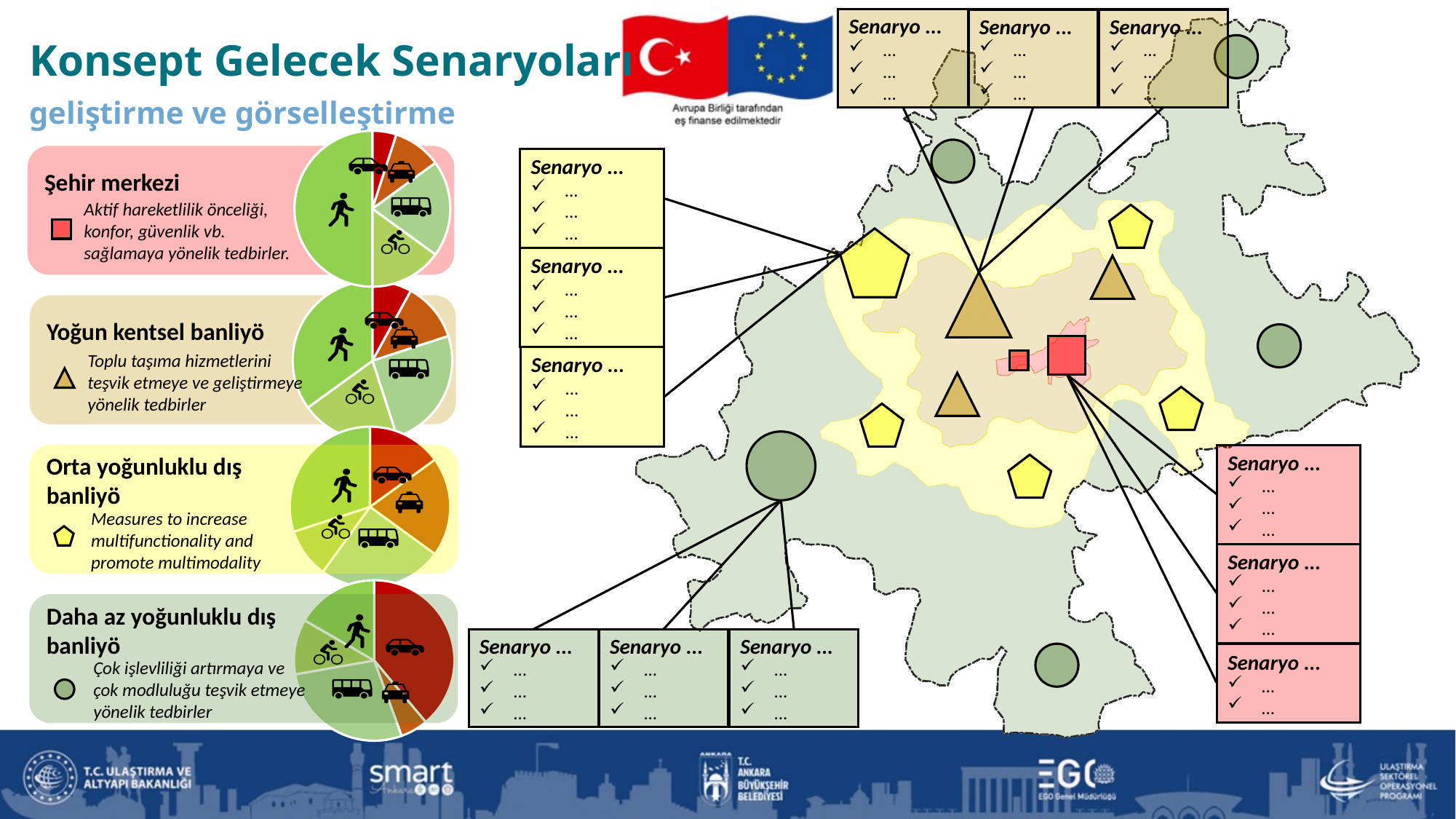
What colour is the walking slice in the pie chart next to "Şehir merkezi"? green What is the main title of the slide? Konsept Gelecek Senaryoları In the pie chart next to "Daha az yoğunluklu dış banliyö", is the car slice larger or smaller than the bicycle slice? larger How many pie charts are shown on the left side of the slide? 4 Which pie chart on the slide has the largest car slice? Daha az yoğunluklu dış banliyö What kind of chart is used next to the "Şehir merkezi" box? pie chart In the pie chart next to "Şehir merkezi", which mode icon sits in the largest slice? walking (pedestrian) In the pie chart next to "Daha az yoğunluklu dış banliyö", which mode icon sits in the largest slice? car In the pie chart next to "Şehir merkezi", is the walking slice larger or smaller than the car slice? larger